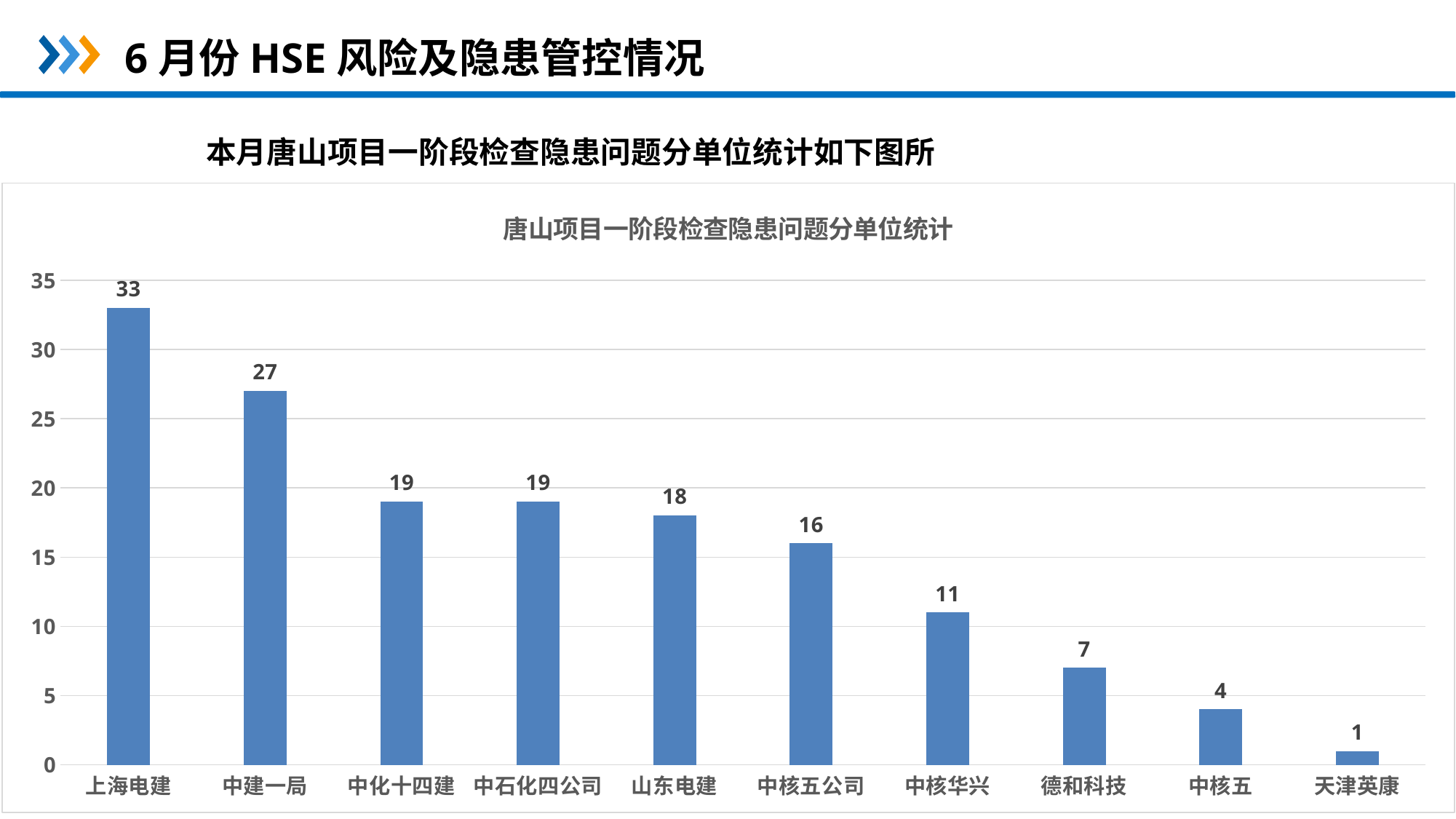
Is the value for 中建一局 greater or less than 25? greater Do the values rise or fall from left to right along the x axis? fall What is the value for 德和科技? 7 What is the value for 上海电建? 33 What kind of chart is this? bar chart How many units are shown on the x axis? 10 Which unit has the highest value? 上海电建 Which is larger, the value for 山东电建 or the value for 中核五公司? 山东电建 What is the value for 中核华兴? 11 What is the difference between the values for 上海电建 and 中建一局? 6 What is the title of the chart? 唐山项目一阶段检查隐患问题分单位统计 Which unit has the lowest value? 天津英康